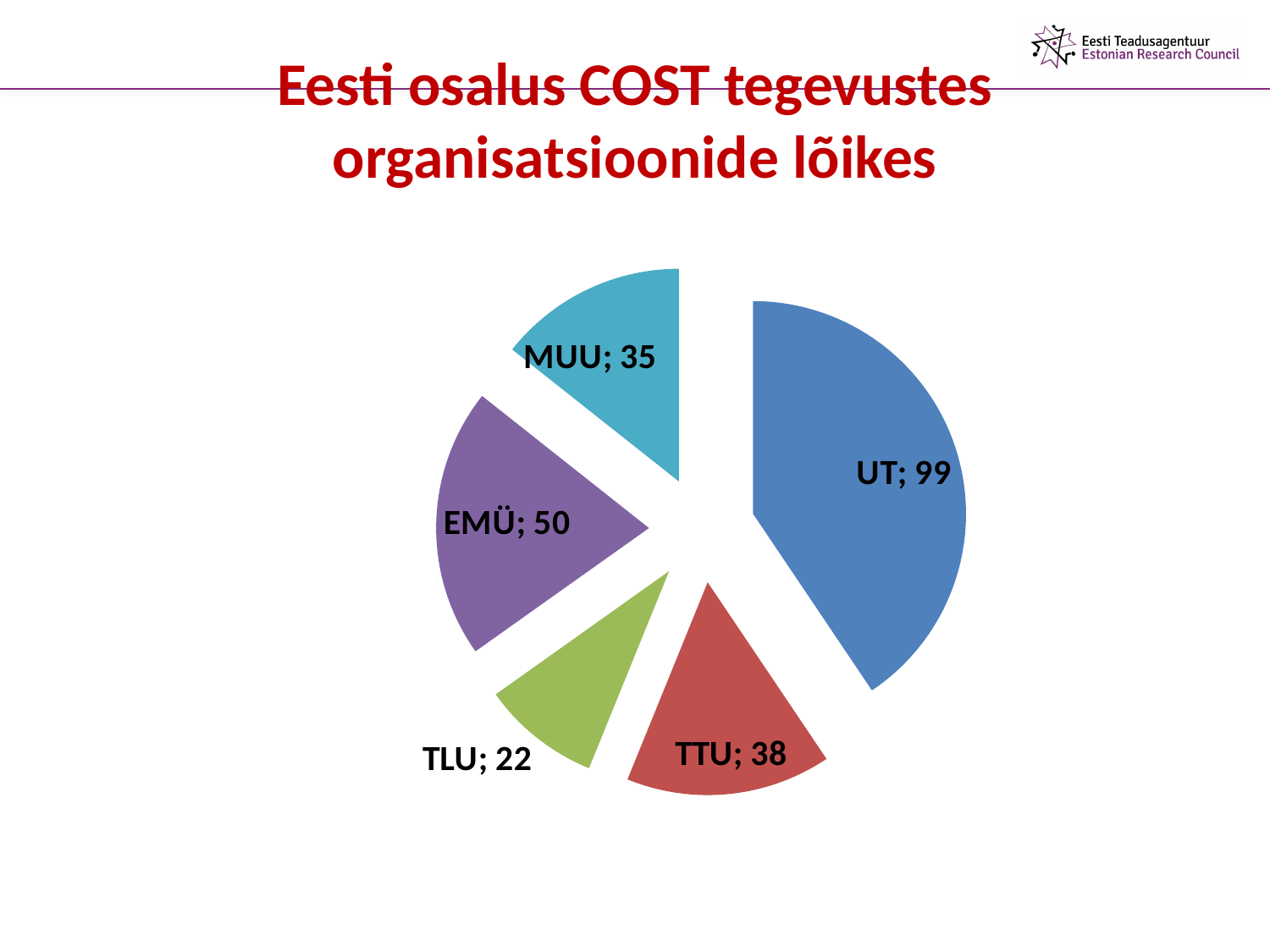
What is the total of all slices in the pie chart? 244 Which organisation has the smallest slice in the pie chart? TLU What is the value for UT in the pie chart? 99 Which organisation has the largest slice in the pie chart? UT What is the value for EMÜ in the pie chart? 50 What is the title of the chart on the slide? Eesti osalus COST tegevustes organisatsioonide lõikes What is the value for MUU in the pie chart? 35 What type of chart is shown on the slide? pie chart How many slices does the pie chart have? 5 What is the difference between the values for UT and EMÜ? 49 Which is larger, the value for TTU or the value for MUU? TTU What is the value for TLU in the pie chart? 22